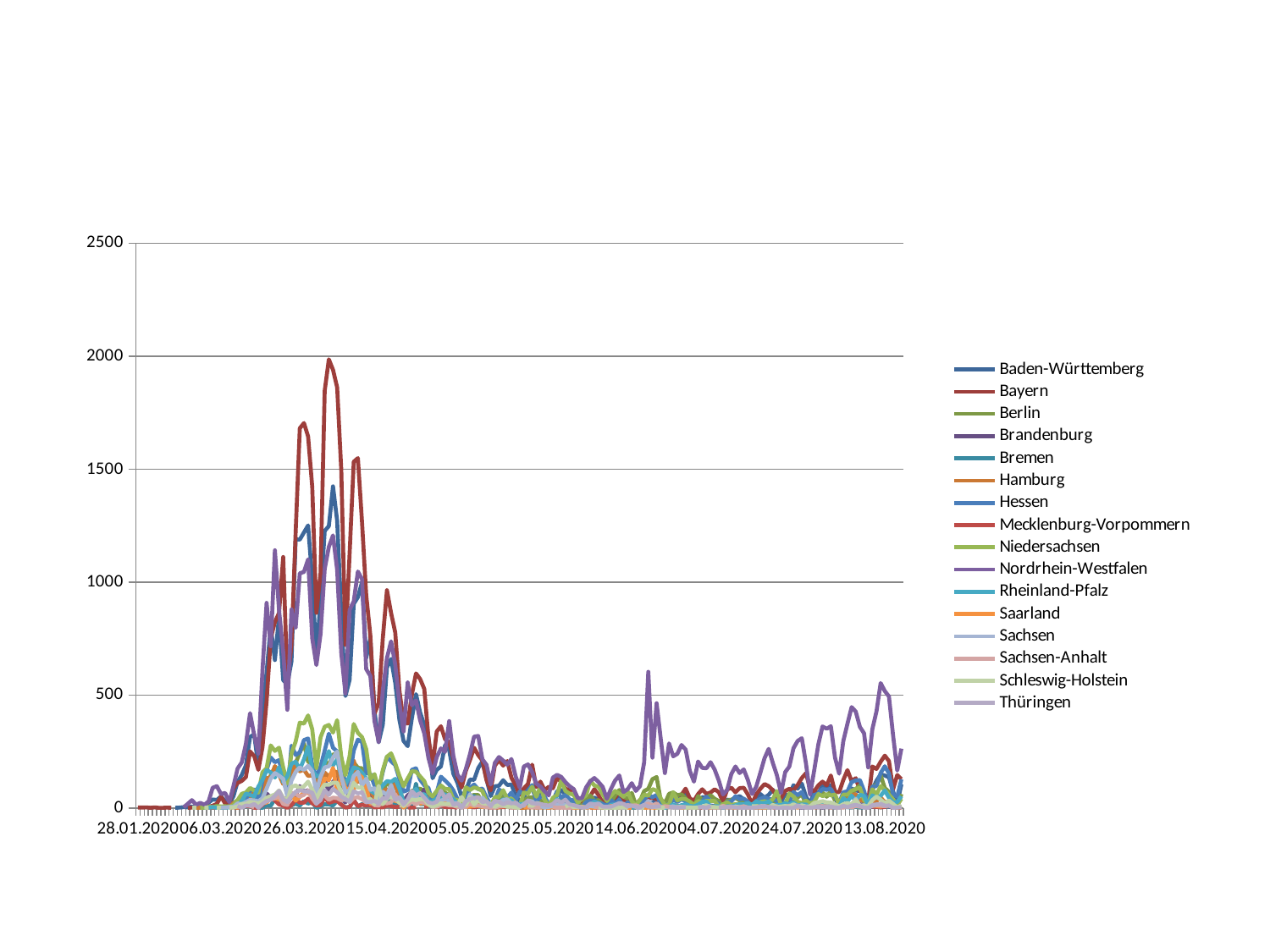
What kind of chart is shown on the slide? line chart What is the first entry listed in the legend? Baden-Württemberg Is the highest value reached by Nordrhein-Westfalen in August 2020 greater or less than 1000? less Which series reaches the highest peak value on the chart? Bayern Is the peak value for Bayern greater or less than 1500? greater What is the highest value shown on the y axis? 2500 Is the value for Bayern at 28.01.2020 greater or less than 500? less Which series reaches a higher peak, Bayern or Hamburg? Bayern How many date labels are shown on the x axis? 10 How many series does the legend list? 16 Which series has the highest values around 13.08.2020? Nordrhein-Westfalen Do the values for Bayern rise or fall between 15.04.2020 and 25.05.2020? fall